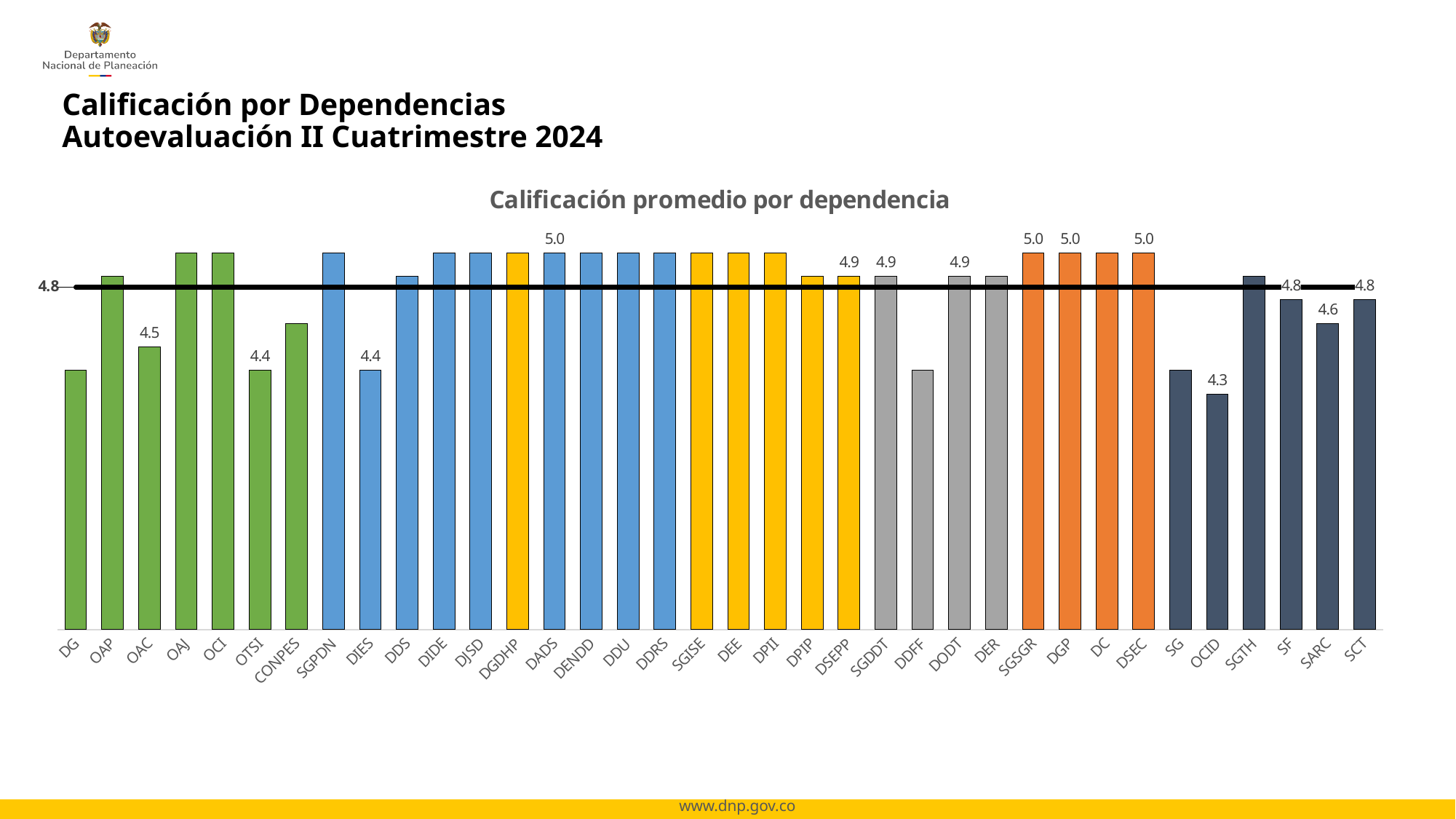
What is the value for SARC? 4.6 Is the value for OAJ greater or less than 4.8? greater Which is larger, the value for SARC or the value for OCID? SARC How many dependencias are shown on the x axis? 36 What is the value for OAC? 4.5 What is the value for OCID? 4.3 Is the value for DG greater or less than 4.8? less What is the difference between the values for DSEC and OCID? 0.7 Which dependencia has the lowest value? OCID What is the difference between the values for SF and SARC? 0.2 What kind of chart is shown? combination bar and line chart What is the value for DSEC? 5.0